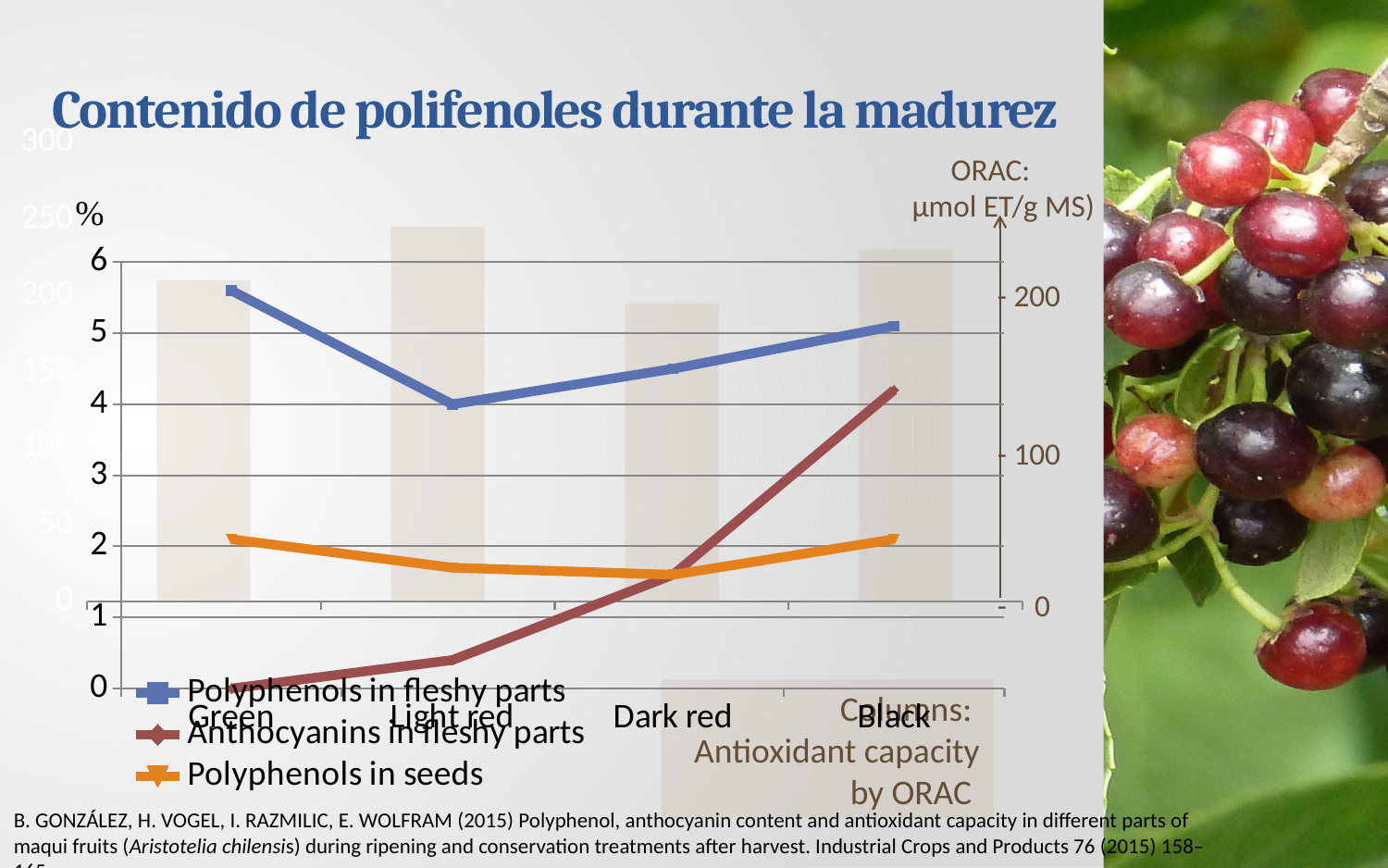
At which ripening stage is the value for Anthocyanins in fleshy parts highest? Black How many ripening stages are shown on the x axis? 4 Which ripening stage has the tallest column for antioxidant capacity by ORAC? Light red Is the value for Anthocyanins in fleshy parts at Black greater or less than 3? greater At the Green stage, which is larger: Polyphenols in fleshy parts or Polyphenols in seeds? Polyphenols in fleshy parts Do the values for Anthocyanins in fleshy parts rise or fall from Green to Black? Rise What kind of chart is shown on the slide? A combined line and bar chart Is the value for Polyphenols in seeds at Light red greater or less than 2? less Is the value for Polyphenols in fleshy parts at Green greater or less than 5? greater How many series does the legend list? 3 At which ripening stage is the value for Polyphenols in fleshy parts lowest? Light red What colour is the line for Polyphenols in seeds? Orange